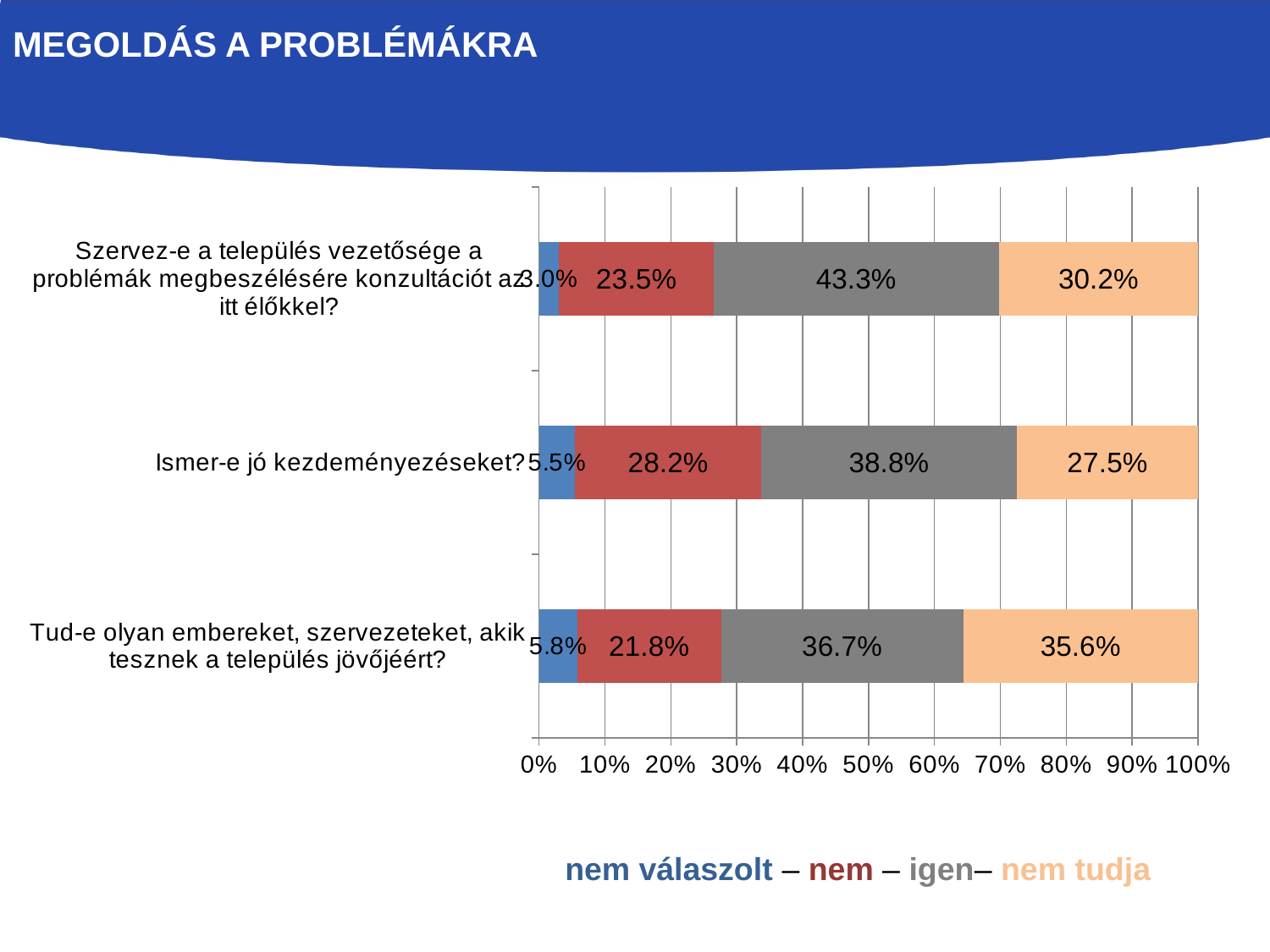
How much larger is the "nem tudja" share for "Tud-e olyan embereket..." than for "Ismer-e jó kezdeményezéseket?"? 8.1 percentage points How many questions (categories) are shown in the chart? 3 Which question has the lowest "nem" share? Tud-e olyan embereket, szervezeteket, akik tesznek a település jövőjéért? Which colour represents the "nem" responses in the chart? Red Which question has the highest "igen" share? Szervez-e a település vezetősége a problémák megbeszélésére konzultációt az itt élőkkel? What kind of chart is shown on the slide? Stacked bar chart What is the "nem tudja" share for "Tud-e olyan embereket, szervezeteket, akik tesznek a település jövőjéért?"? 35.6% What percentage answered "igen" to "Ismer-e jó kezdeményezéseket?"? 38.8% What is the "nem" value for the question about whether the settlement leadership organises consultations ("Szervez-e a település vezetősége...")? 23.5% What is the total of the stacked bar for "Ismer-e jó kezdeményezéseket?"? 100.0% How many response categories (series) does the legend list? 4 For "Tud-e olyan embereket, szervezeteket, akik tesznek a település jövőjéért?", which is larger: the "igen" share or the "nem tudja" share? igen